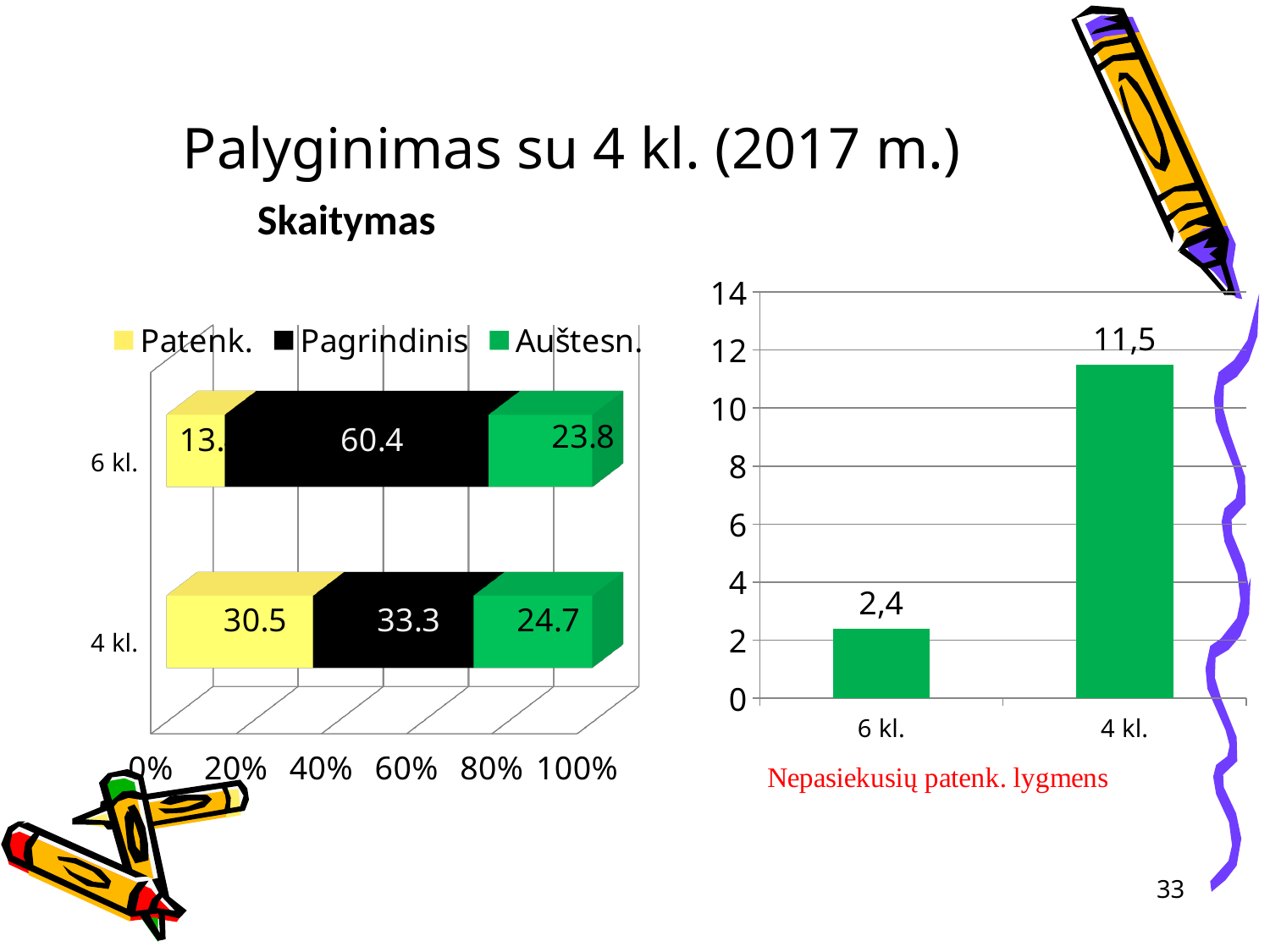
On the left chart (Skaitymas), what is the Pagrindinis value for 6 kl.? 60.4 On the left chart (Skaitymas), which is larger: the Pagrindinis value for 6 kl. or for 4 kl.? 6 kl. On the right chart, what is the value for 6 kl.? 2,4 On the right chart, which category has the higher value? 4 kl. On the left chart (Skaitymas), what is the difference between the Pagrindinis values for 6 kl. and 4 kl.? 27.1 On the right chart, is the value for 4 kl. greater or less than 10? greater On the right chart, what is the difference between the values for 4 kl. and 6 kl.? 9,1 On the left chart (Skaitymas), what is the Auštesn. value for 4 kl.? 24.7 On the left chart (Skaitymas), how many series does the legend list? 3 On the right chart, what is the value for 4 kl.? 11,5 On the left chart (Skaitymas), what is the Patenk. value for 4 kl.? 30.5 What kind of chart is the right chart? bar chart